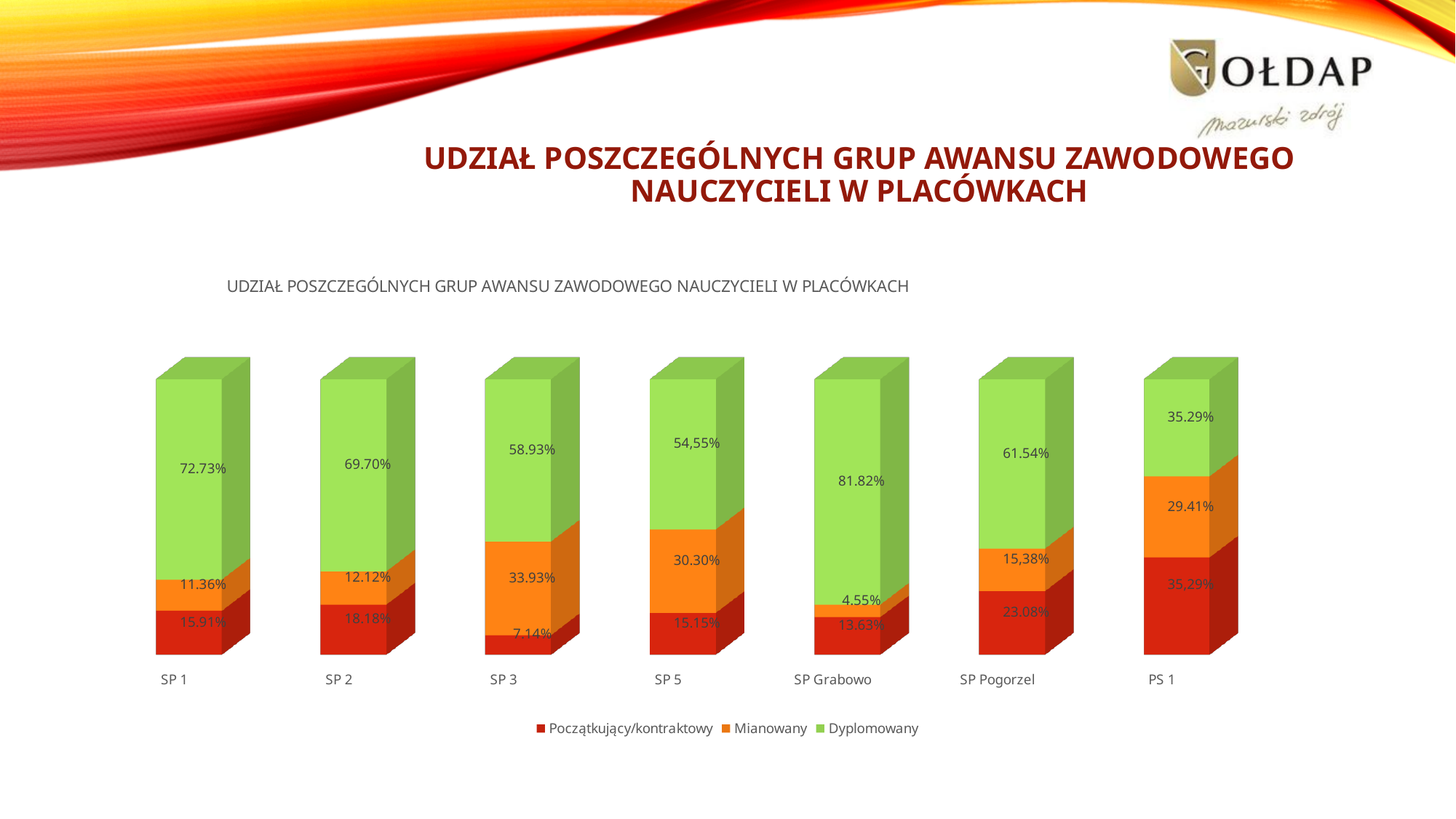
What is the Początkujący/kontraktowy share for SP Pogorzel? 23.08% What is the Dyplomowany share for SP 5? 54,55% What is the Dyplomowany share for SP Grabowo? 81.82% What is the difference between the Dyplomowany shares of SP 1 and SP 2? 3.03% Which category has the lowest Początkujący/kontraktowy share? SP 3 Which is larger: the Mianowany share for SP 5 or for SP Pogorzel? SP 5 Which category has the highest Dyplomowany share? SP Grabowo What is the Mianowany share for SP 3? 33.93% What kind of chart is shown on the slide? Stacked bar chart How many series does the legend list? 3 How many categories are shown on the x axis? 7 Which category has the lowest Dyplomowany share? PS 1